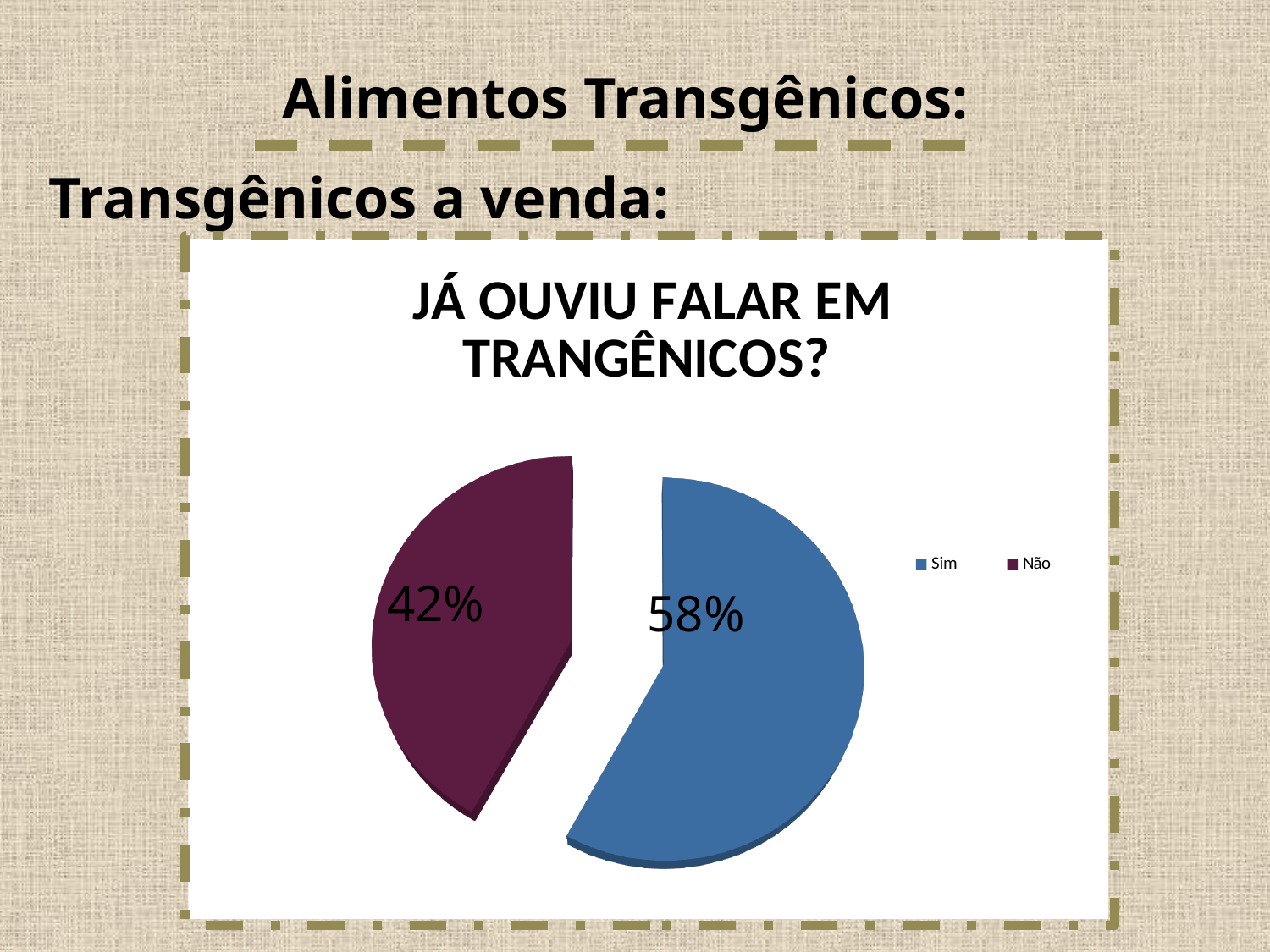
Which is larger, the "Sim" slice or the "Não" slice? Sim What is the difference in percentage points between the "Sim" and "Não" slices? 16 Which slice of the pie is the largest? Sim Which slice of the pie is the smallest? Não What kind of chart is shown on the slide? pie chart What colour is the "Não" slice? dark purple What percentage of the pie is labelled for "Sim"? 58% What is the title of the chart? JÁ OUVIU FALAR EM TRANGÊNICOS? How many slices does the pie chart have? 2 What share of the pie does the "Sim" slice represent? 58% What percentage of the pie is labelled for "Não"? 42% How many entries does the legend list? 2